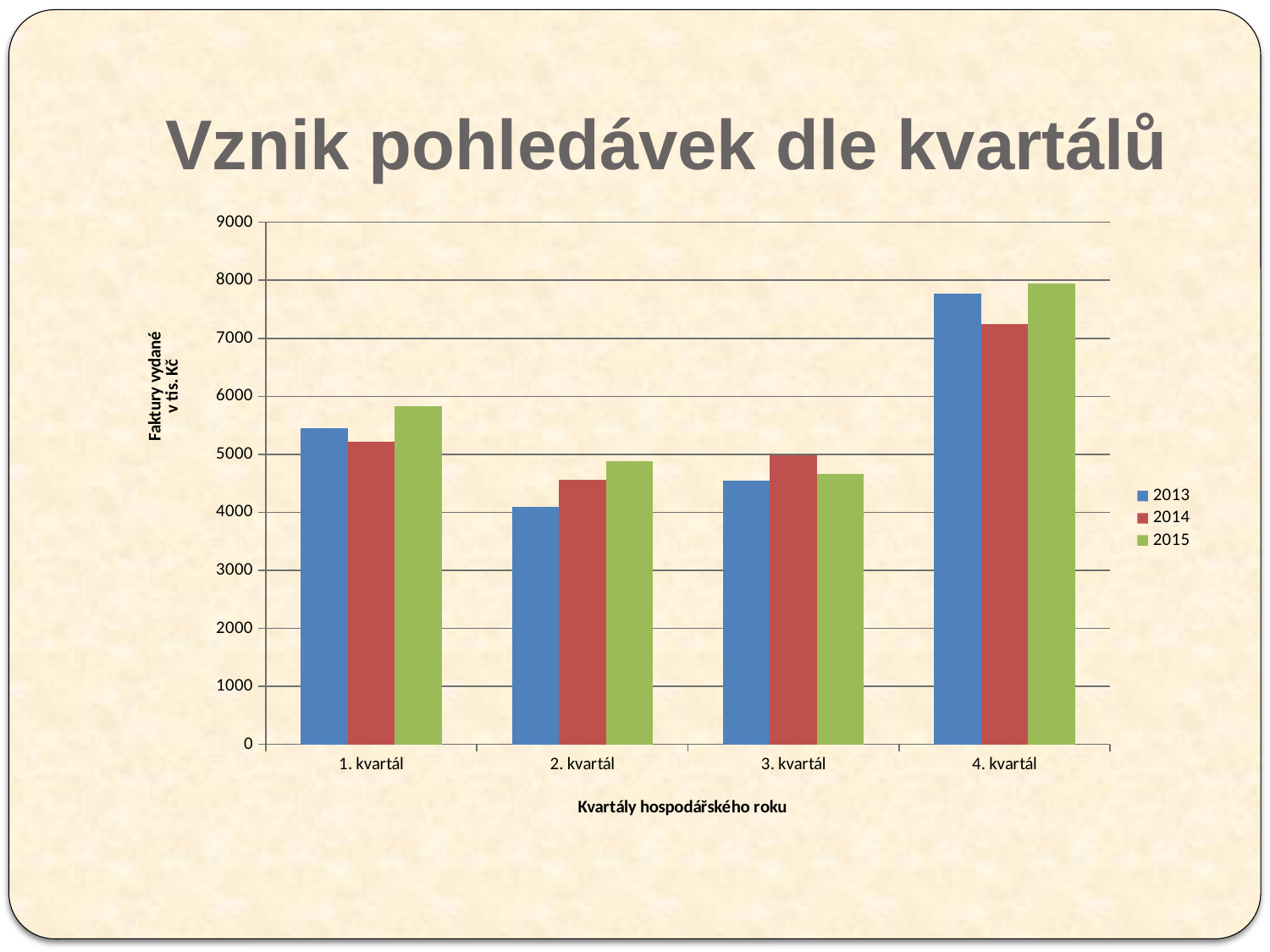
Is the value for 2015 in 2. kvartál greater or less than 5000? less In which quarter is the value for 2013 lowest? 2. kvartál What is the title of the chart on the slide? Vznik pohledávek dle kvartálů How many series does the legend list? 3 How many quarters (categories) are shown on the x axis? 4 In which quarter is the value for 2015 highest? 4. kvartál Is the value for 2014 in 4. kvartál greater or less than 7000? greater In 1. kvartál, which is larger: the value for 2013 or for 2014? 2013 Is the value for 2015 in 1. kvartál greater or less than 6000? less In 2. kvartál, which is larger: the value for 2013 or for 2014? 2014 What type of chart is shown on the slide? bar chart